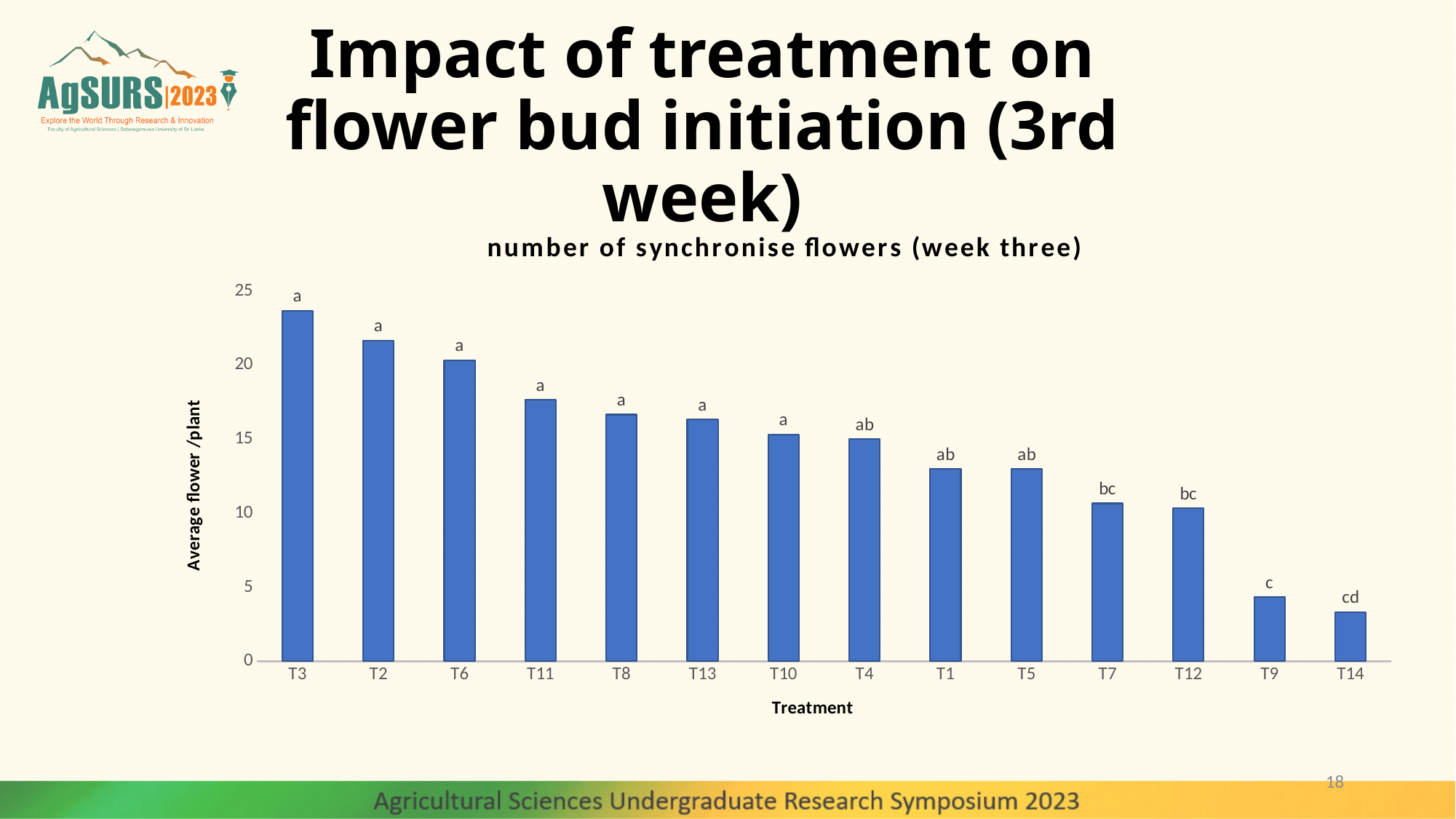
How many treatments are plotted on the x axis? 14 Is the value for T3 greater or less than 20? greater Which has a larger value, T3 or T2? T3 Which treatment has the lowest average flower per plant? T14 Is the value for T11 greater or less than 15? greater Which treatment has the highest average flower per plant? T3 What letter label is printed above the bar for T14? cd What is the title of the chart? number of synchronise flowers (week three) Do the bar values rise or fall moving from left to right along the x axis? fall What kind of chart is shown on the slide? bar chart Is the value for T1 greater or less than 15? less